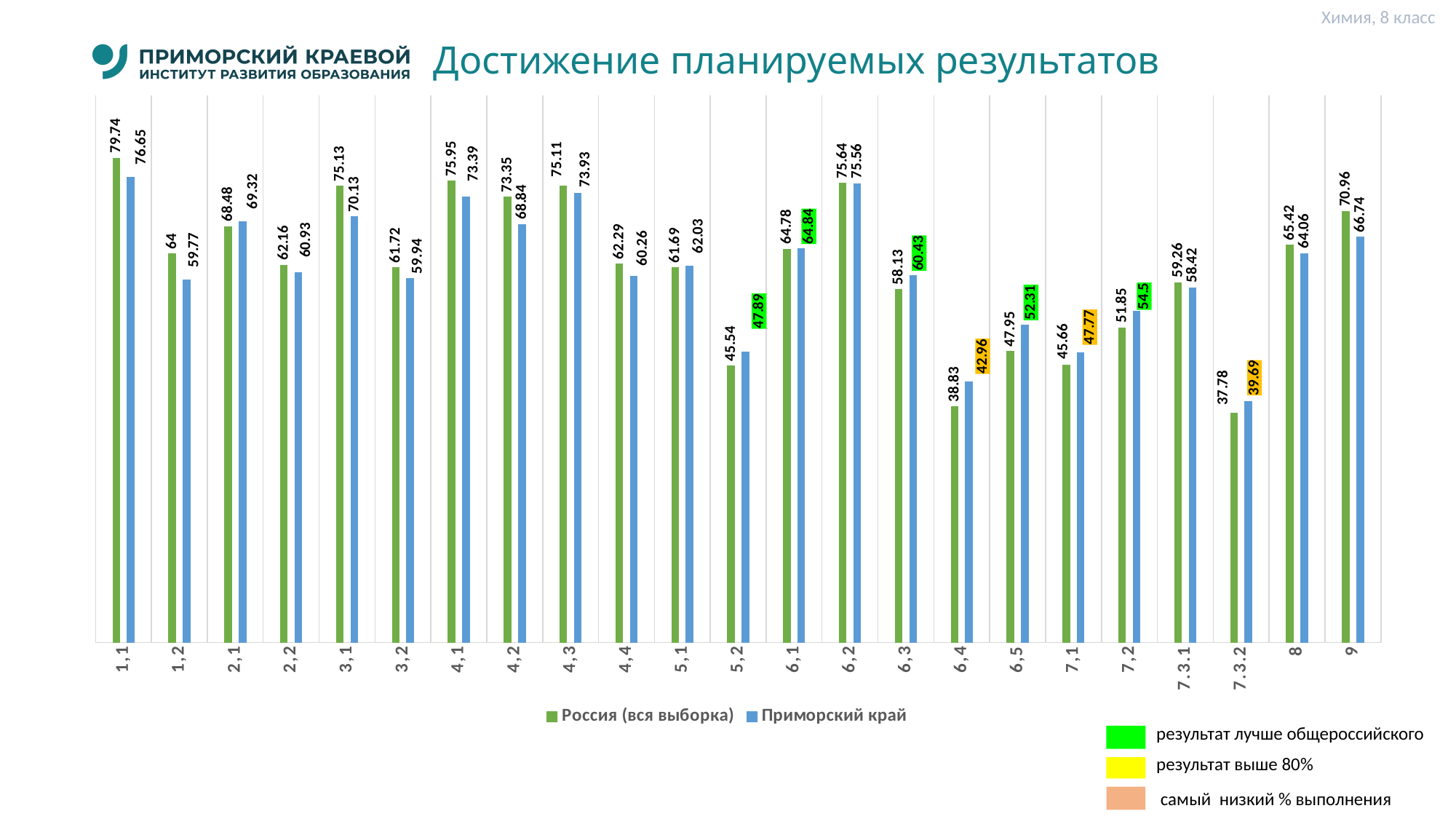
How many categories are shown on the x axis? 23 How many series does the legend list? 2 Which category has the lowest value for Россия (вся выборка)? 7.3.2 For category 4,2, which series has the larger value: Россия (вся выборка) or Приморский край? Россия (вся выборка) What is the value for Россия (вся выборка) for category 1,1? 79.74 What is the value for Приморский край for category 7,3,2? 39.69 What is the value for Приморский край for category 6,4? 42.96 What is the difference between Россия (вся выборка) and Приморский край for category 3,1? 5 What kind of chart is shown on the slide? Bar chart For category 6,5, which series has the larger value: Россия (вся выборка) or Приморский край? Приморский край What is the title of the slide's chart? Достижение планируемых результатов Which category has the highest value for Приморский край? 1,1